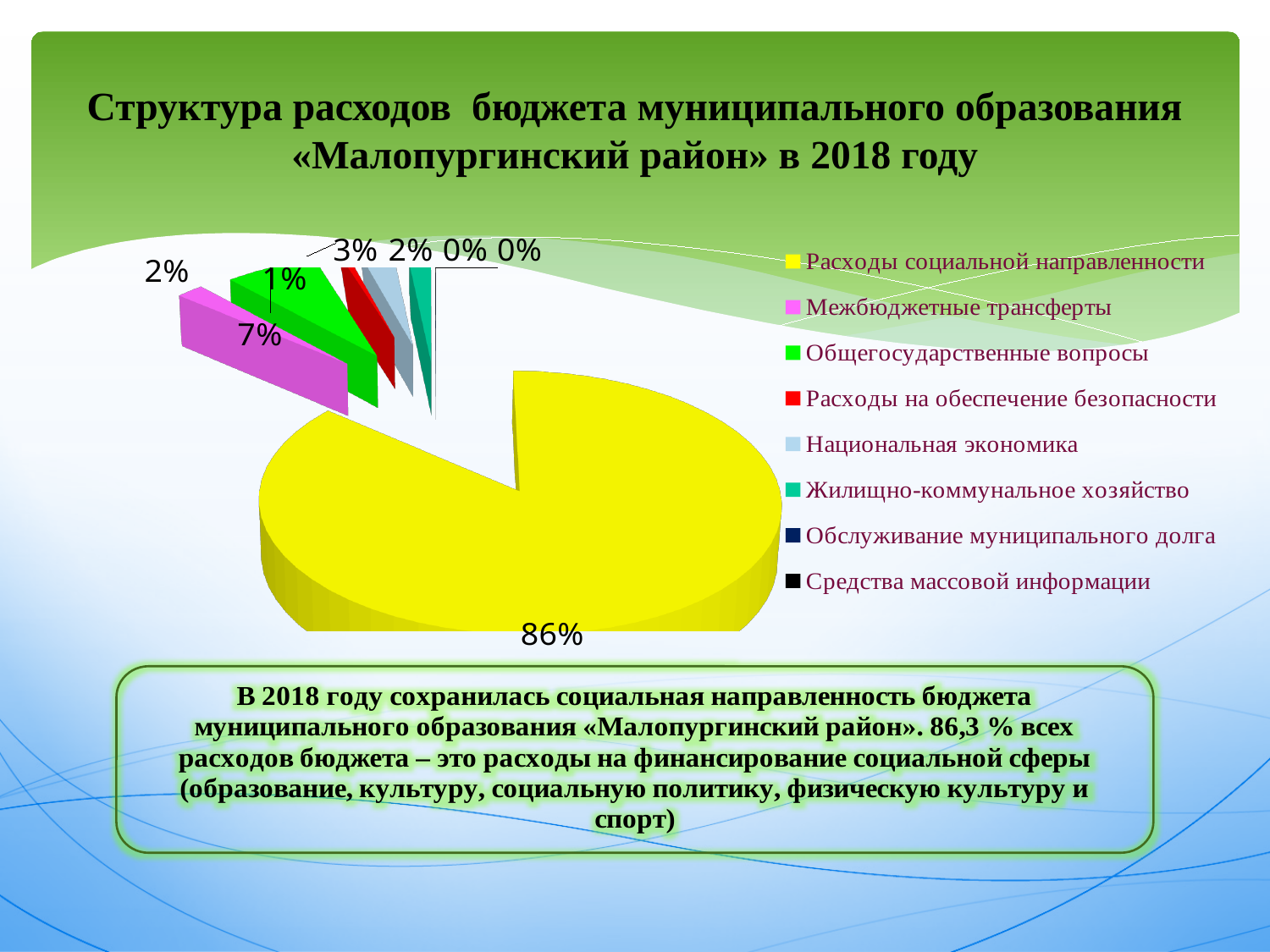
How many slices does the pie chart have? 8 What share of the pie is labelled for «Межбюджетные трансферты»? 2% What is the smallest share value printed on the pie chart? 0% What share of the budget expenses is labelled for «Расходы социальной направленности»? 86% By how many percentage points does the share for «Расходы социальной направленности» exceed the share for «Межбюджетные трансферты»? 84 Which is larger: the share for «Расходы социальной направленности» or for «Межбюджетные трансферты»? Расходы социальной направленности Which category has the largest share of the pie? Расходы социальной направленности How many categories does the legend list? 8 Which legend entry is shown with a pink marker? Межбюджетные трансферты What kind of chart is shown on the slide? pie chart What colour is the slice for «Расходы социальной направленности»? yellow